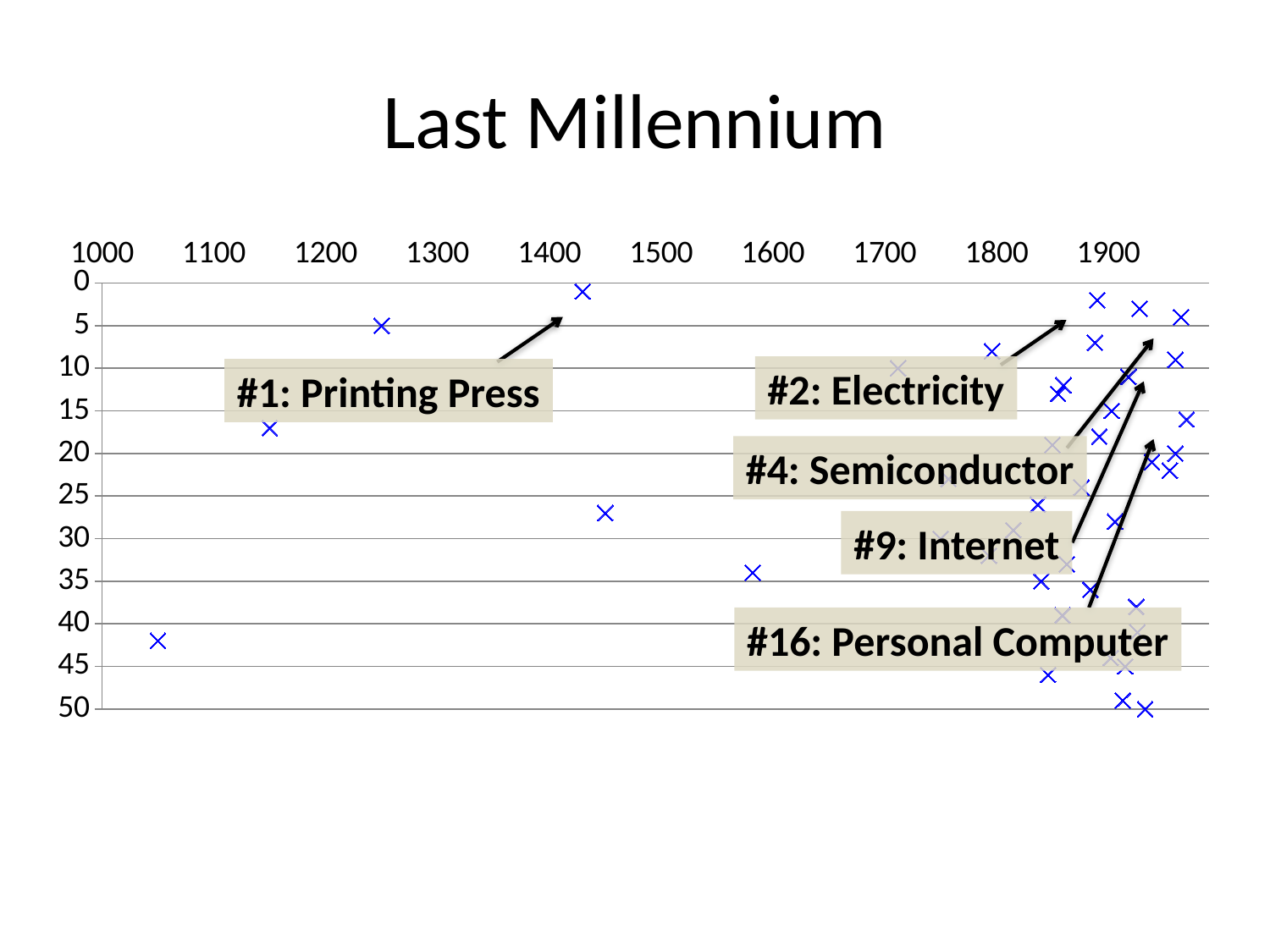
What is the largest value shown on the vertical axis? 50 Which annotated invention has the highest rank number on the chart? #16: Personal Computer What is the title of the slide's chart? Last Millennium Which invention is annotated as #9 on the chart? Internet Which invention is annotated as #1 on the chart? Printing Press Which annotated invention has the lowest rank number on the chart? #1: Printing Press Is the year of the Electricity point greater or less than 1800? greater How many labelled inventions are annotated on the chart? 5 Is the year of the Printing Press point greater or less than 1400? greater Is the rank value of the Printing Press point greater or less than 5? less What kind of chart is shown on the slide? scatter chart